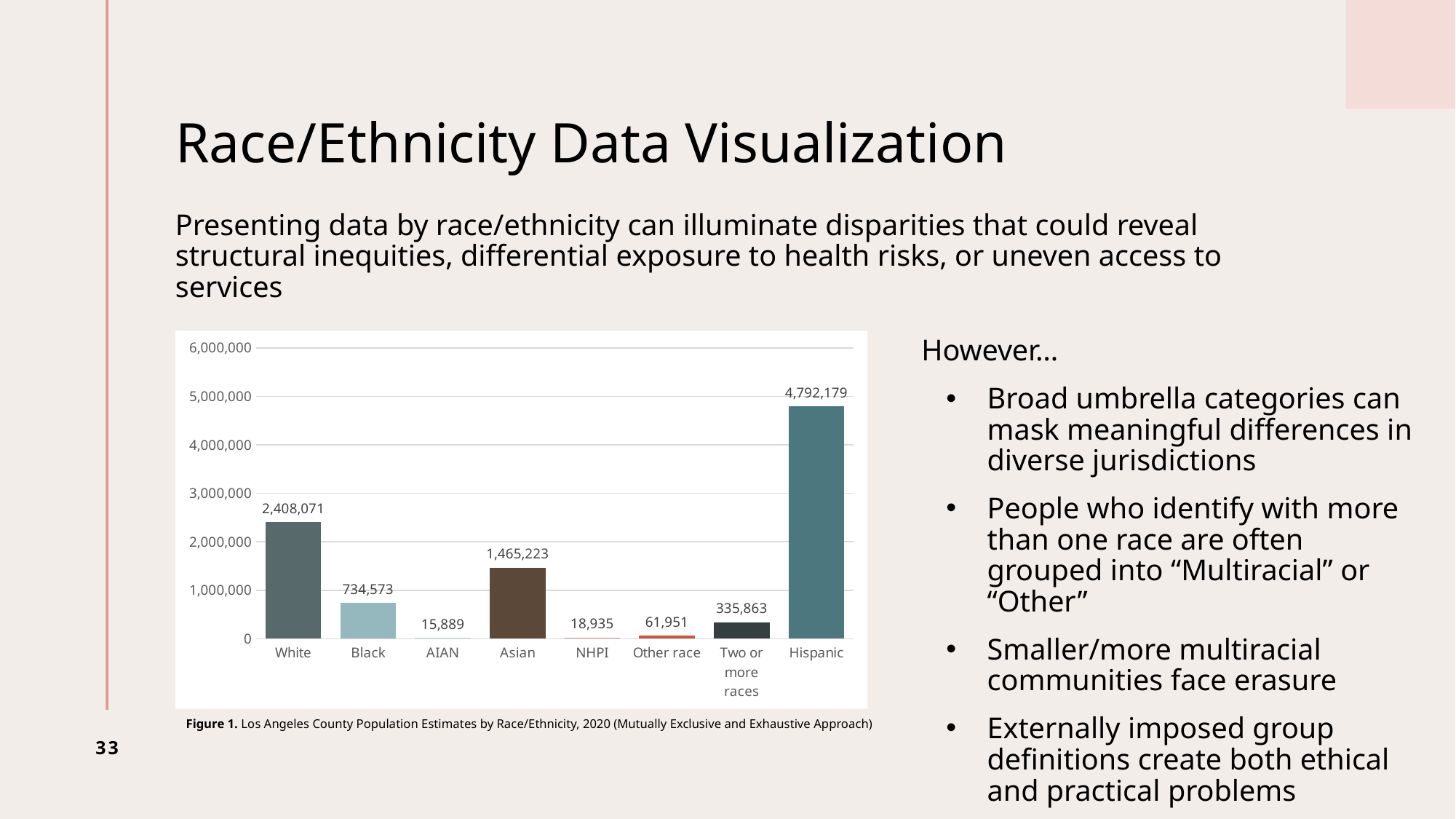
What is the population estimate for the Black category? 734,573 What is the population estimate for the Hispanic category? 4,792,179 What is the difference between the Hispanic and White population estimates? 2,384,108 Which has a larger population estimate, Black or Two or more races? Black Is the value for Asian greater or less than 1,000,000? greater Which race/ethnicity category has the lowest population estimate? AIAN Which race/ethnicity category has the highest population estimate? Hispanic How many race/ethnicity categories are shown on the x axis? 8 What is the difference between the White and Asian population estimates? 942,848 What is the population estimate for the Two or more races category? 335,863 What is the figure caption for the chart? Figure 1. Los Angeles County Population Estimates by Race/Ethnicity, 2020 (Mutually Exclusive and Exhaustive Approach) What kind of chart is shown on the slide? Bar chart